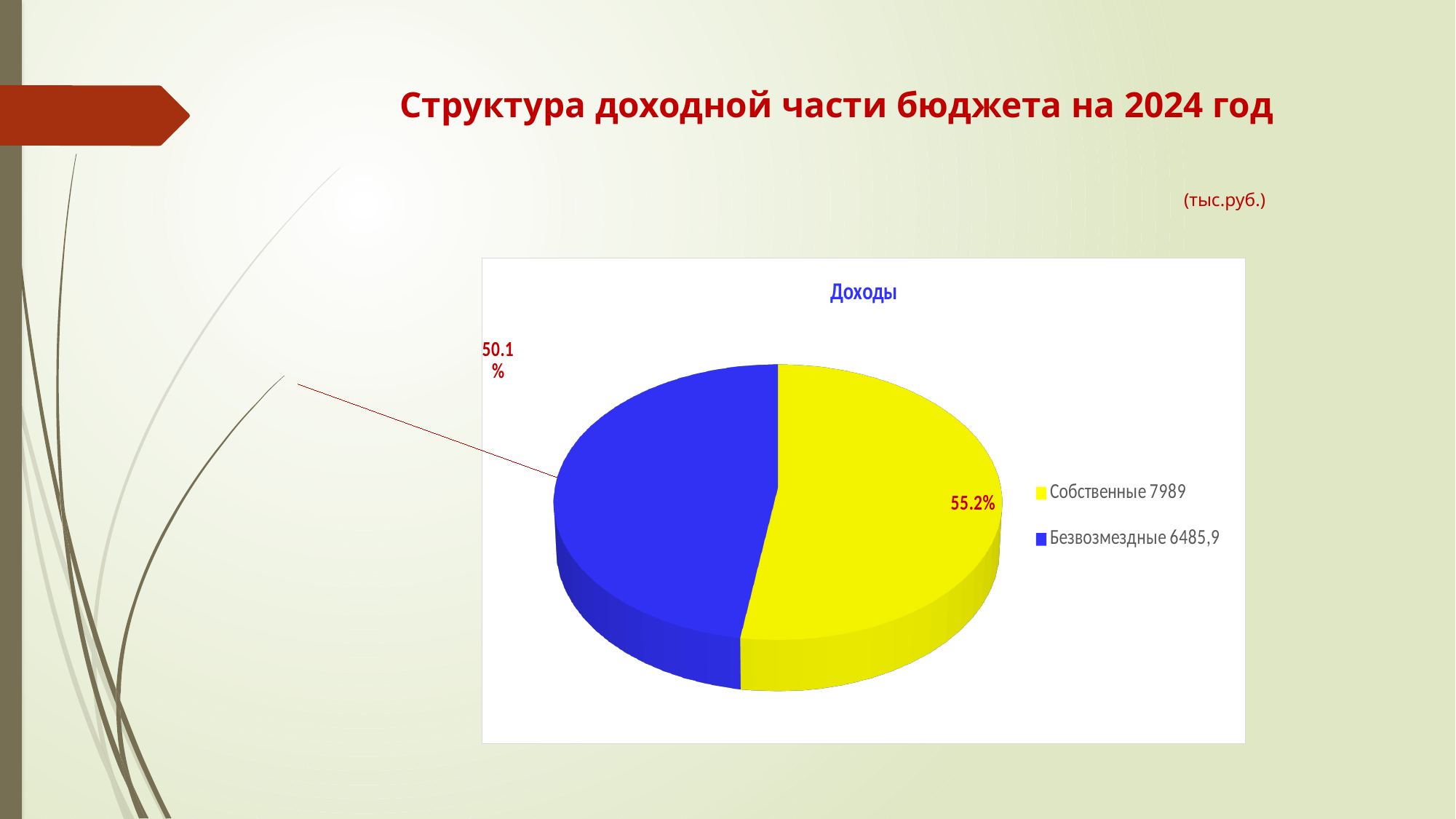
What colour is the Собственные slice? yellow What percentage label is shown for the Безвозмездные slice? 50.1% Which category has the smallest value in the chart? Безвозмездные What value is shown in the legend for Собственные? 7989 What is the title of the chart? Доходы What percentage label is shown on the Собственные slice? 55.2% What value is shown in the legend for Безвозмездные? 6485,9 What kind of chart is shown on the slide? pie chart What is the difference between the values for Собственные and Безвозмездные? 1503,1 How many entries does the chart legend list? 2 Which category has the larger value, Собственные or Безвозмездные? Собственные How many slices does the pie chart have? 2